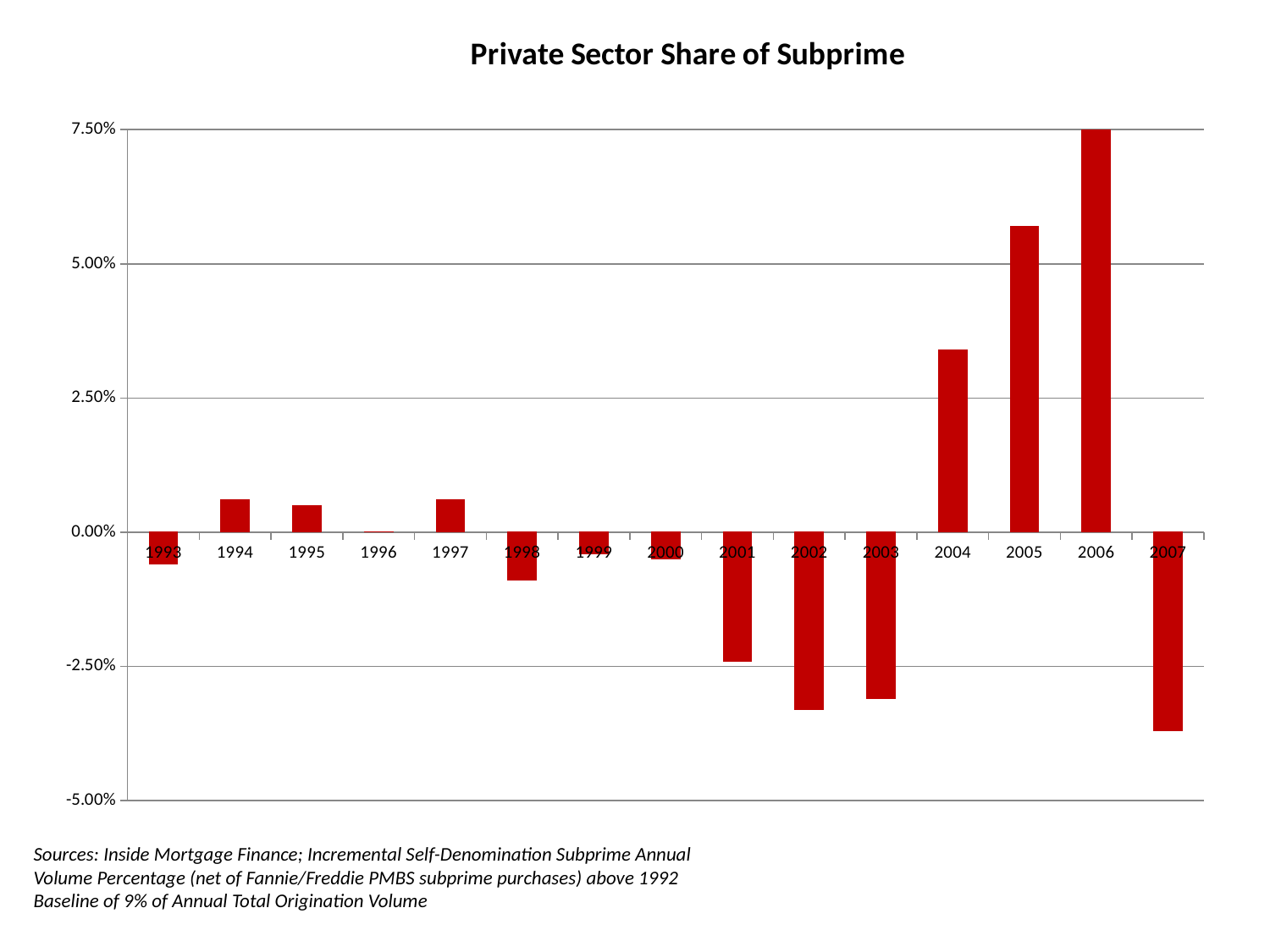
Which year has the highest value in the chart? 2006 Which year has the larger value, 1997 or 2001? 1997 How many years are shown on the x axis of the chart? 15 Is the value for 2005 greater or less than 5.00%? greater Which year has the lowest value in the chart? 2007 What is the title of the chart? Private Sector Share of Subprime Is the value for 1998 greater or less than 0.00%? less Do the values rise or fall from 2004 to 2006? rise Which year has the larger value, 2004 or 2005? 2005 Is the value for 2002 greater or less than -2.50%? less What type of chart is shown on the slide? bar chart